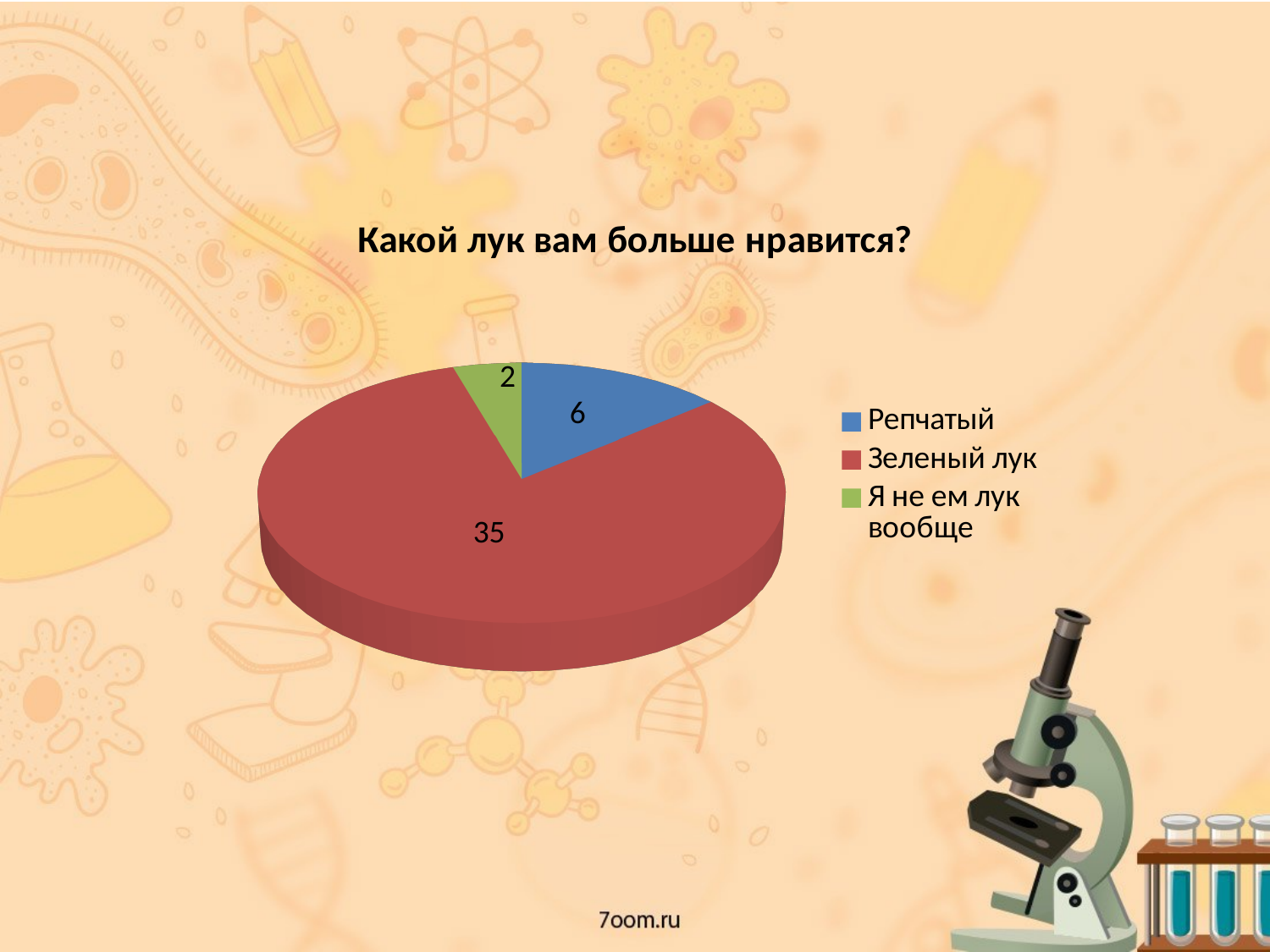
Which category has the largest slice of the pie? Зеленый лук What is the difference between the values for Репчатый and Я не ем лук вообще? 4 What is the total of all the slices in the pie chart? 43 What is the difference between the values for Зеленый лук and Репчатый? 29 What is the value for Зеленый лук? 35 What is the value for Репчатый? 6 Which is larger, the value for Репчатый or the value for Я не ем лук вообще? Репчатый What is the title of the chart? Какой лук вам больше нравится? Which category has the smallest slice of the pie? Я не ем лук вообще How many categories does the pie chart show? 3 What kind of chart is shown on the slide? Pie chart What is the value for Я не ем лук вообще? 2